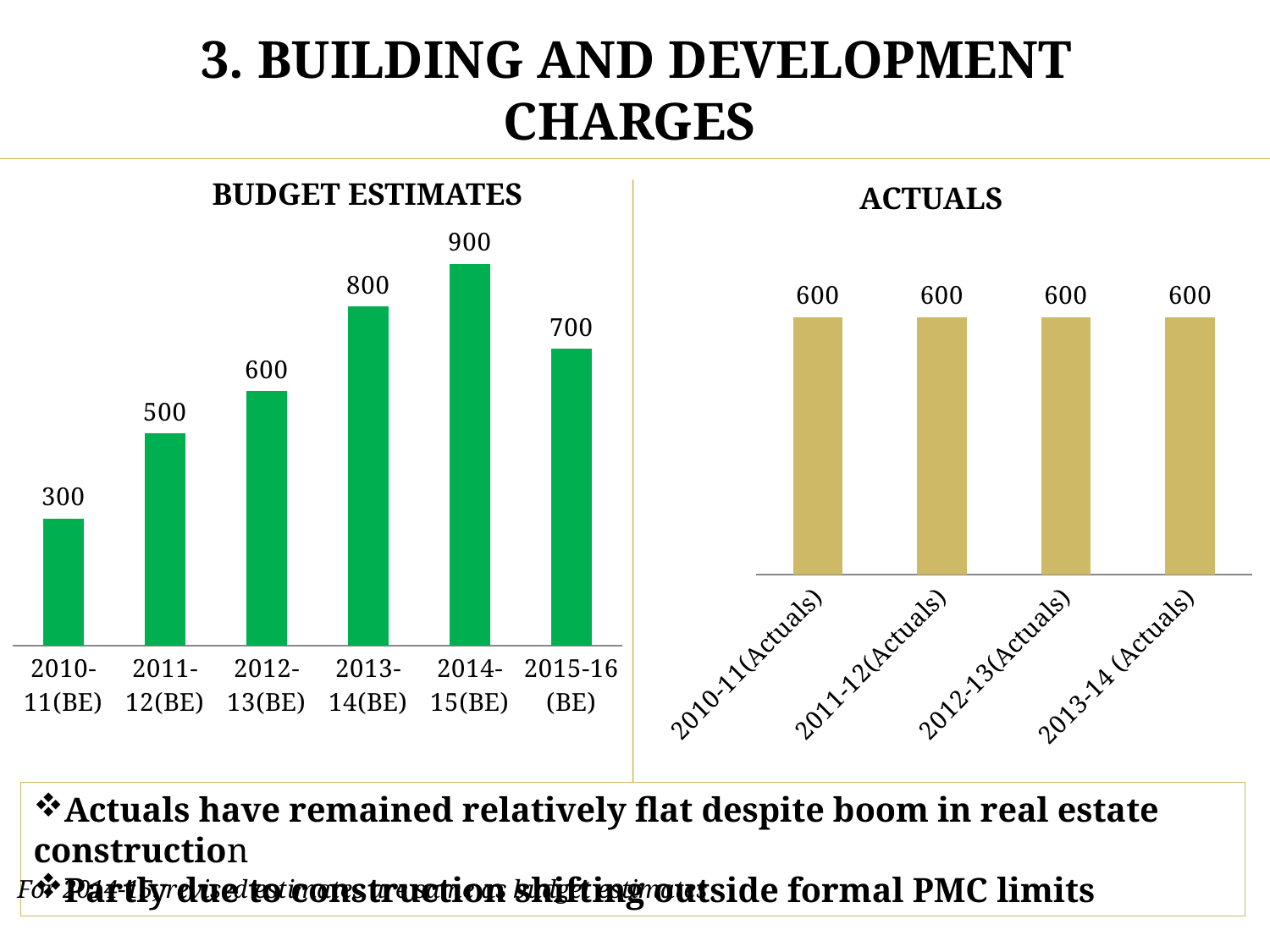
In the ACTUALS chart, what is the value for 2012-13(Actuals)? 600 How many categories are shown in the BUDGET ESTIMATES chart? 6 In the BUDGET ESTIMATES chart, what is the value for 2010-11(BE)? 300 In the BUDGET ESTIMATES chart, do the values rise or fall from 2010-11(BE) to 2014-15(BE)? Rise What kind of chart is the ACTUALS chart? Bar chart In the BUDGET ESTIMATES chart, what is the value for 2013-14(BE)? 800 What colour are the bars in the BUDGET ESTIMATES chart? Green In the BUDGET ESTIMATES chart, which is larger, the value for 2012-13(BE) or the value for 2015-16 (BE)? 2015-16 (BE) In the BUDGET ESTIMATES chart, what is the difference between the values for 2014-15(BE) and 2015-16 (BE)? 200 In the BUDGET ESTIMATES chart, which category has the highest value? 2014-15(BE) How many bars are shown in the ACTUALS chart? 4 In the BUDGET ESTIMATES chart, which category has the lowest value? 2010-11(BE)